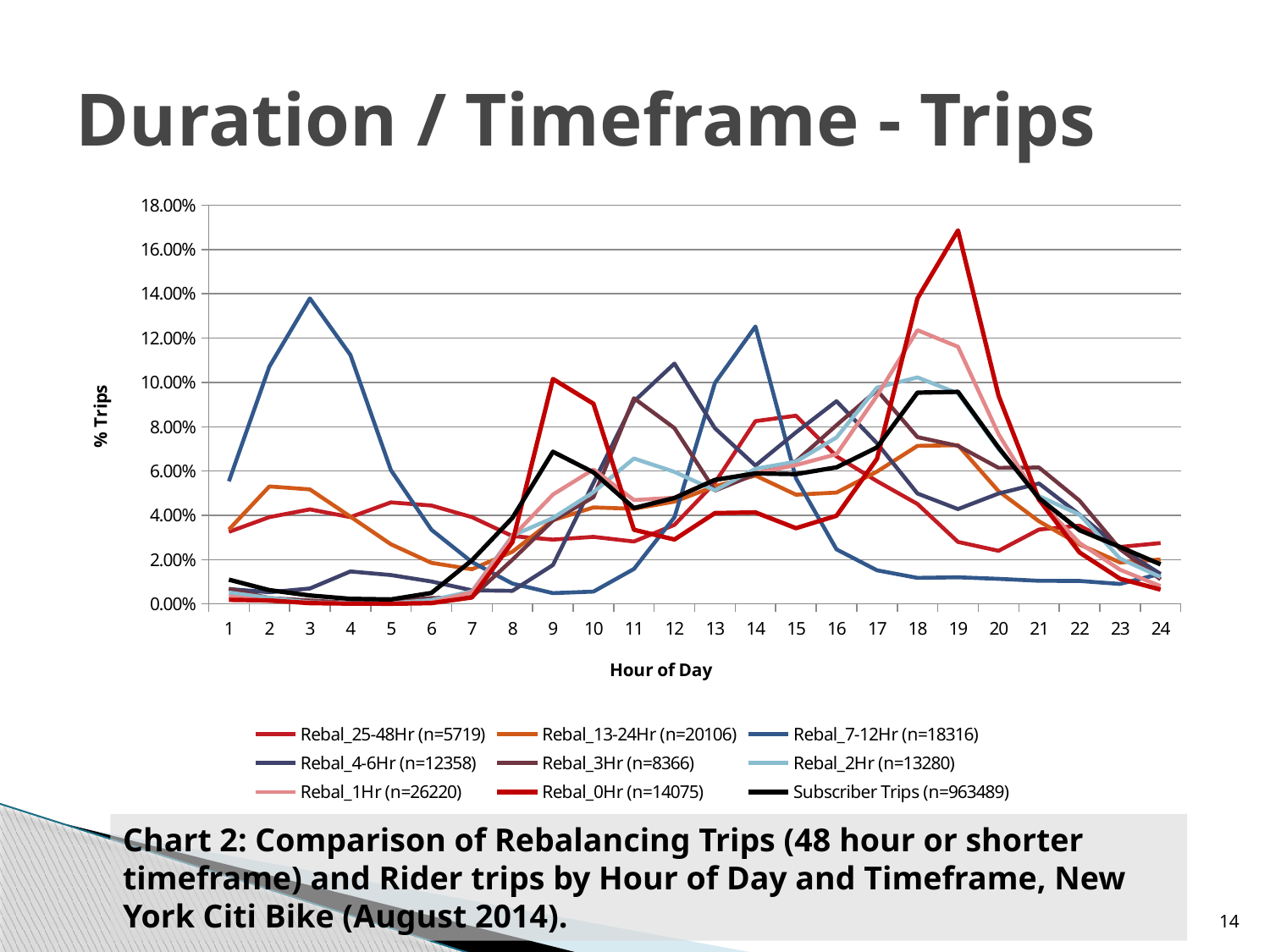
How many hours are plotted along the x axis? 24 What is the label on the y axis of the chart? % Trips Is the value for Rebal_1Hr (n=26220) at hour 18 greater or less than 10.00%? greater Is the value for Rebal_0Hr (n=14075) at hour 19 greater or less than 16.00%? greater At which hour of day does the Rebal_7-12Hr (n=18316) series reach its highest value? 3 What kind of chart is shown on the slide? line chart How many series does the legend list? 9 At which hour of day does the Rebal_0Hr (n=14075) series reach its peak? 19 Does the Subscriber Trips (n=963489) series rise or fall from hour 19 to hour 24? fall Which series reaches the highest value anywhere on the chart? Rebal_0Hr (n=14075) Is the value for Subscriber Trips (n=963489) at hour 18 greater or less than 8.00%? greater At hour 3, which series has the higher value, Rebal_7-12Hr (n=18316) or Rebal_13-24Hr (n=20106)? Rebal_7-12Hr (n=18316)